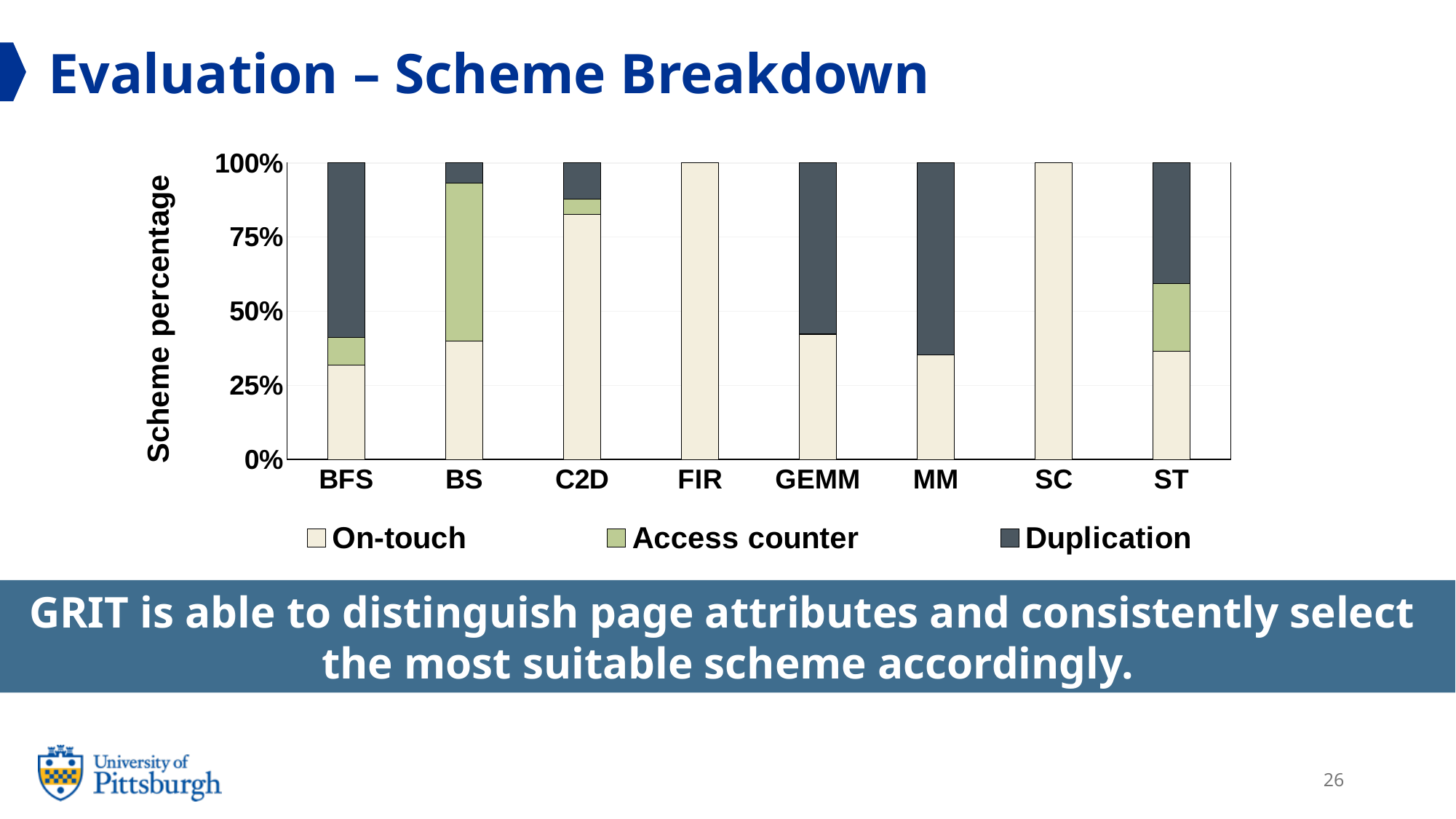
What kind of chart is shown on the slide? Stacked bar chart What are the three series listed in the legend? On-touch, Access counter, Duplication Is the On-touch value for BFS greater or less than 50%? less Which has a larger On-touch share, C2D or BFS? C2D Which category has the largest Access counter segment? BS Is the Duplication value for MM greater or less than 50%? greater Is the On-touch value for C2D greater or less than 75%? greater How many series does the legend list? 3 What is the On-touch percentage for SC? 100% How many categories (benchmarks) are shown on the x axis? 8 What is the On-touch percentage for FIR? 100% What is the label of the y axis? Scheme percentage